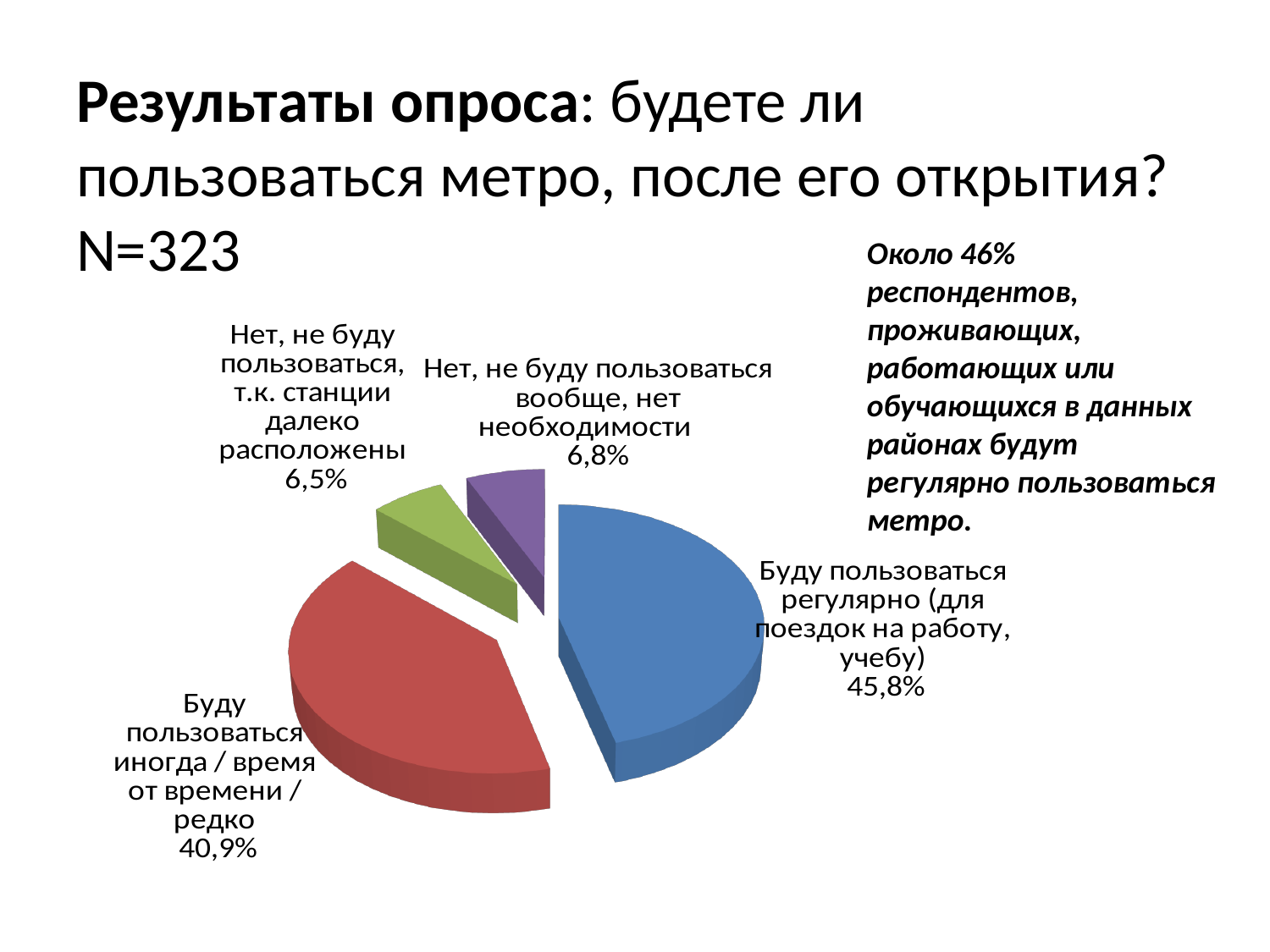
What is the combined share of the two "Нет" answer options? 13,3% What kind of chart is shown on the slide? Pie chart Which is larger: the share for "Нет, не буду пользоваться вообще, нет необходимости" or the share for "Нет, не буду пользоваться, т.к. станции далеко расположены"? Нет, не буду пользоваться вообще, нет необходимости What share of respondents answered "Нет, не буду пользоваться вообще, нет необходимости"? 6,8% How many slices does the pie chart have? 4 What share of respondents answered "Нет, не буду пользоваться, т.к. станции далеко расположены"? 6,5% What colour is the slice for "Буду пользоваться иногда / время от времени / редко"? Red Which answer option has the smallest share in the pie chart? Нет, не буду пользоваться, т.к. станции далеко расположены What share of respondents answered "Буду пользоваться иногда / время от времени / редко"? 40,9% By how many percentage points does the share of "Буду пользоваться регулярно" exceed the share of "Буду пользоваться иногда / время от времени / редко"? 4,9 What share of respondents answered "Буду пользоваться регулярно (для поездок на работу, учебу)"? 45,8% Which answer option has the largest share in the pie chart? Буду пользоваться регулярно (для поездок на работу, учебу)